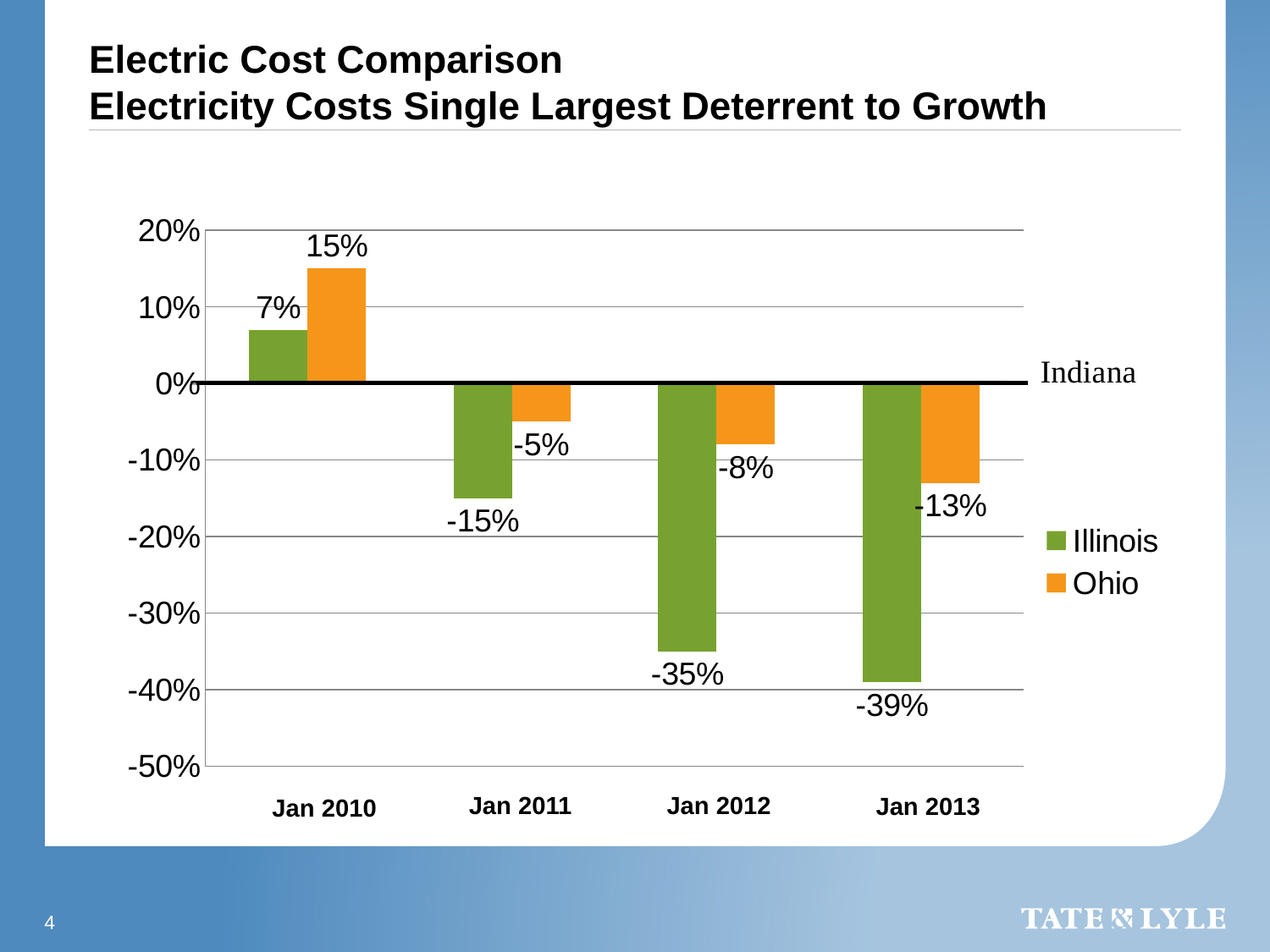
Do the Illinois values rise or fall from Jan 2010 to Jan 2013? Fall What kind of chart is shown on the slide? Bar chart What is the value for Illinois in Jan 2012? -35% How many series does the legend list? 2 How many periods are shown on the x axis? 4 What is the value for Illinois in Jan 2010? 7% What is the value for Ohio in Jan 2011? -5% In which period is the Illinois value lowest? Jan 2013 What is the value for Ohio in Jan 2013? -13% In which period is the Ohio value highest? Jan 2010 Which is larger in Jan 2012, the Illinois value or the Ohio value? Ohio What is the difference between the Ohio and Illinois values in Jan 2013? 26 percentage points